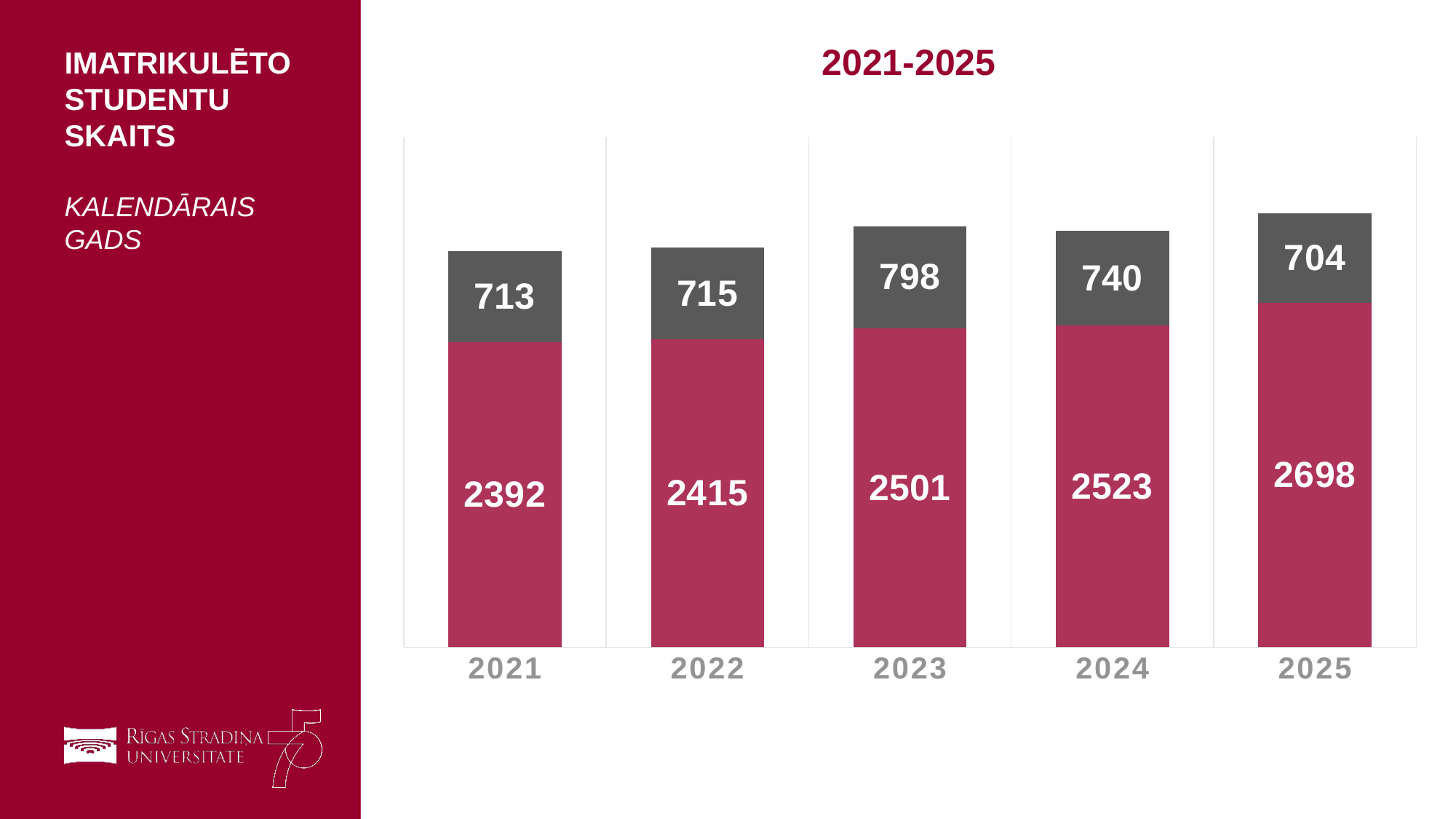
What is the title of the chart? 2021-2025 How many years are shown on the x axis? 5 What is the value of the grey (upper) segment for 2023? 798 Which year has the lowest value in the red (lower) segment? 2021 What is the difference between the red (lower) segment values for 2025 and 2024? 175 Which is larger, the grey (upper) segment for 2024 or for 2025? 2024 What kind of chart is shown on the slide? Stacked bar chart Do the values of the red (lower) segment rise or fall from 2021 to 2025? Rise What is the value of the red (lower) segment for 2021? 2392 What is the total of the stacked bar for 2023? 3299 What is the value of the red (lower) segment for 2025? 2698 Which year has the highest value in the grey (upper) segment? 2023